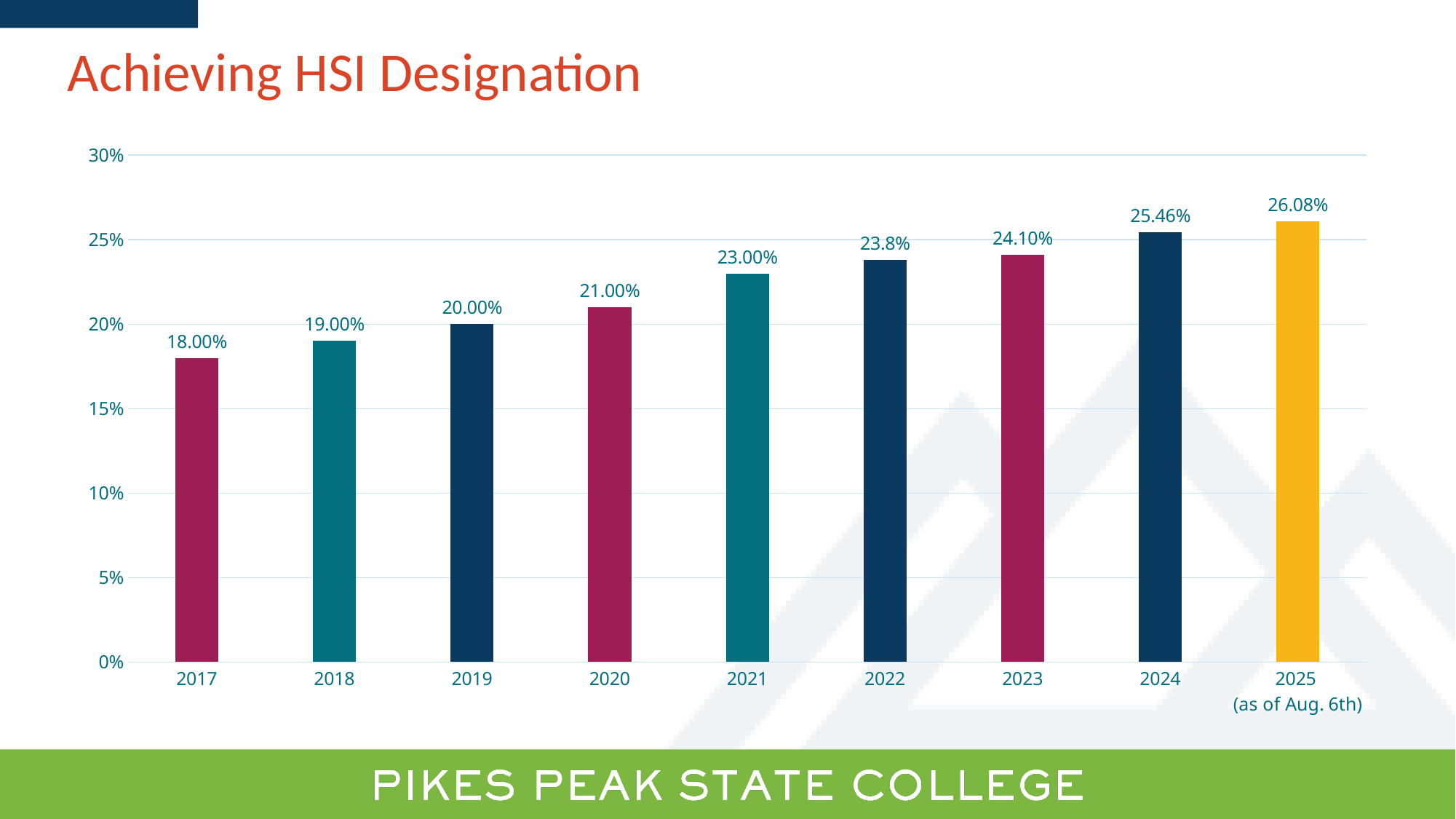
How many years are shown on the x axis? 9 What is the value for 2022? 23.8% Which year has the lowest value? 2017 What is the difference between the values for 2021 and 2017? 5.00% What kind of chart is shown on the slide? bar chart What is the value for 2025 (as of Aug. 6th)? 26.08% Which year has the highest value? 2025 Do the values rise or fall from 2017 to 2025? rise What is the difference between the values for 2024 and 2023? 1.36% Is the value for 2024 greater or less than 25%? greater Which is larger, the value for 2020 or the value for 2019? 2020 What is the value for 2017? 18.00%